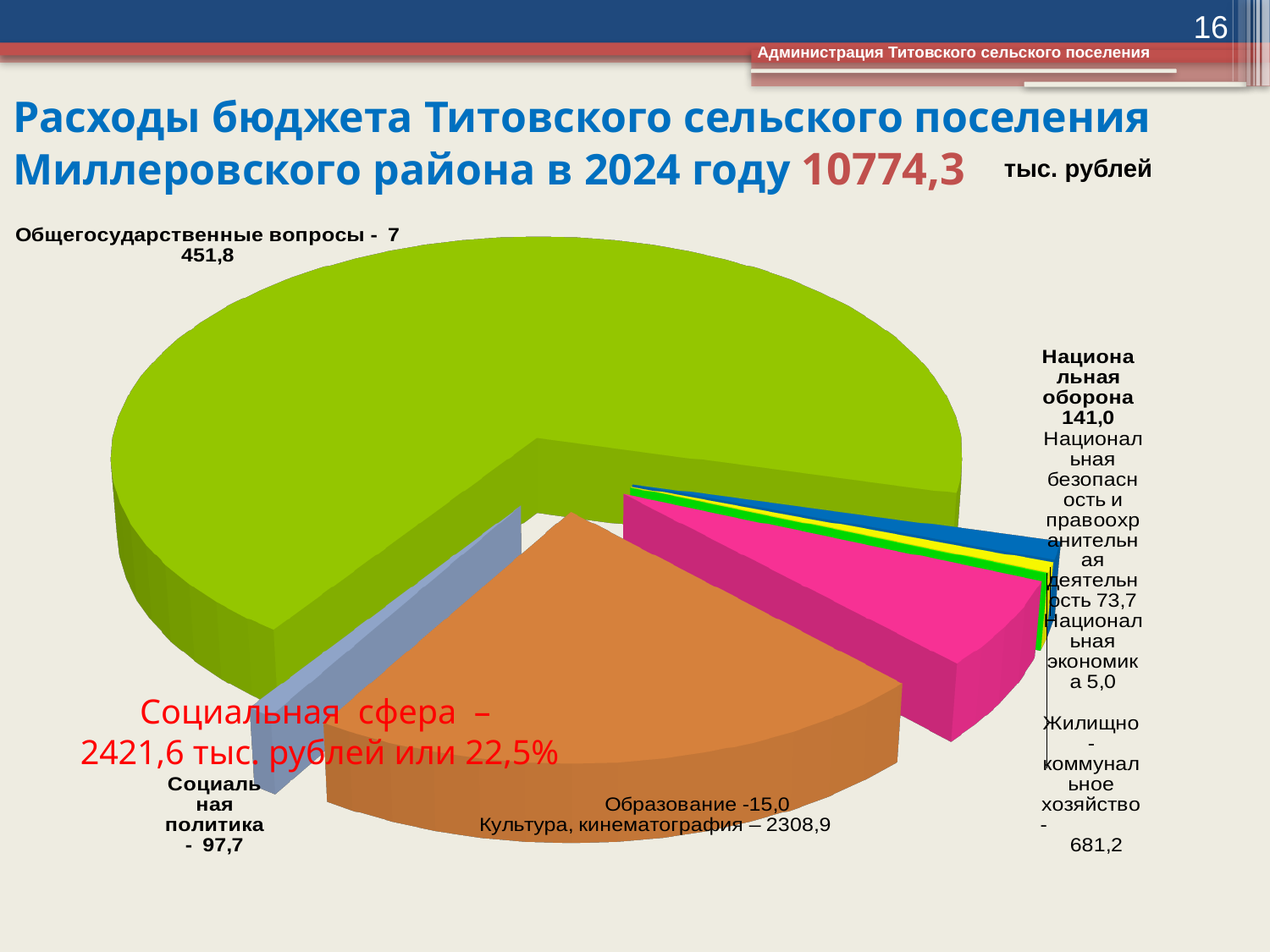
How many expenditure categories are shown in the pie chart? 7 What is the total budget expenditure stated in the slide title, in тыс. рублей? 10774,3 What kind of chart is shown on the slide? pie chart What is the value for Общегосударственные вопросы? 7 451,8 What is the value for Жилищно-коммунальное хозяйство? 681,2 What is the value for Национальная оборона? 141,0 Which is larger: Национальная оборона or Социальная политика? Национальная оборона What is the value for Культура, кинематография? 2308,9 What is the difference between Национальная оборона and Национальная безопасность и правоохранительная деятельность? 67,3 What share of the budget does the Социальная сфера account for, according to the slide? 22,5% Which category has the smallest value? Национальная экономика Which category has the largest slice of the pie? Общегосударственные вопросы